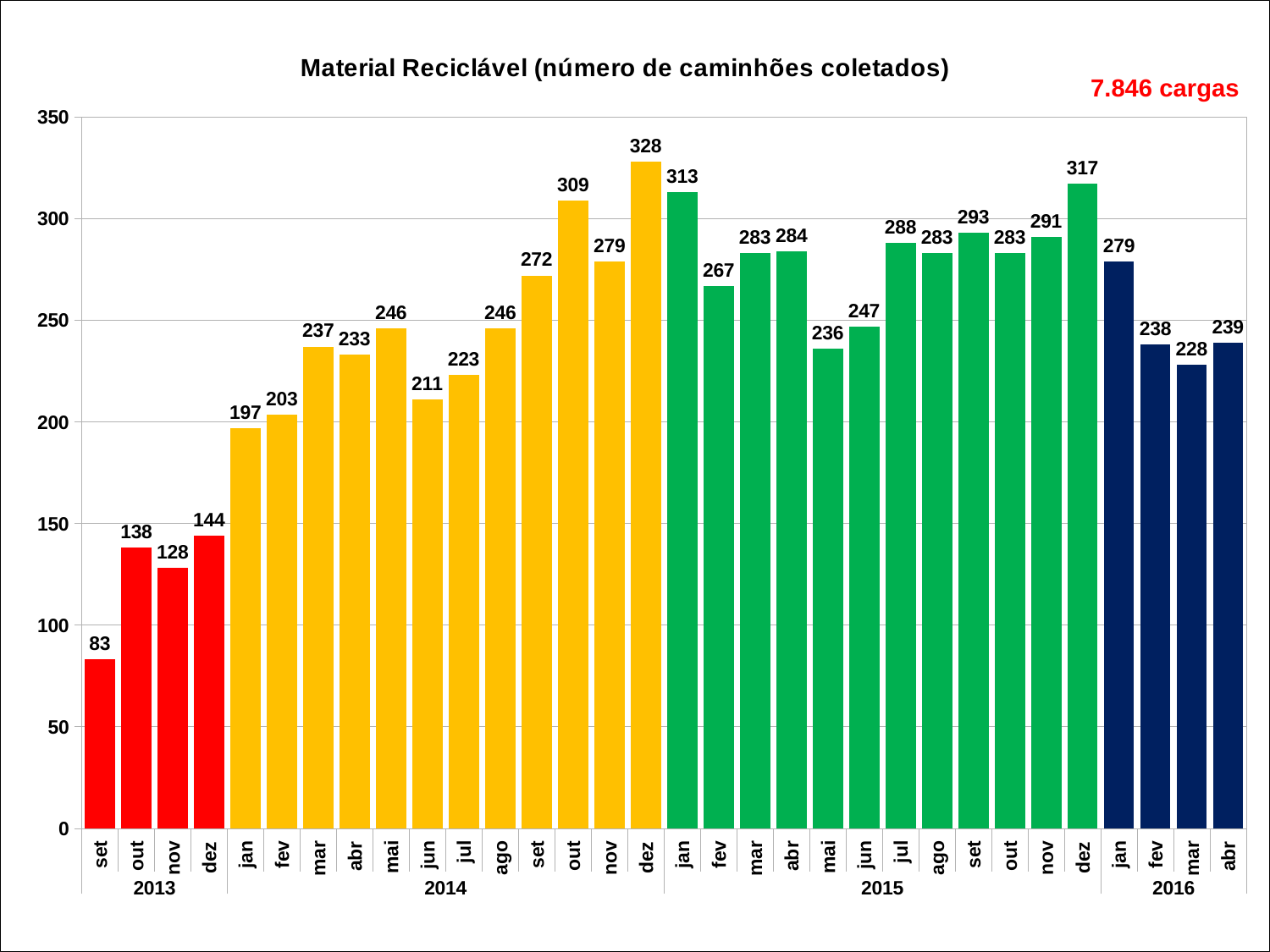
How many bars are plotted in the chart? 32 What is the difference between dez 2015 and jan 2016? 38 What total is printed in red at the top right of the chart? 7.846 cargas What kind of chart is shown? bar chart What is the value for dez 2014? 328 What is the value for abr 2016? 239 Which month has the lowest value? set 2013 Which is larger, out 2014 or jan 2015? jan 2015 What is the value for mai 2015? 236 What is the value for set 2013? 83 Do the values rise or fall from set 2013 to dez 2013? rise Which month has the highest value? dez 2014